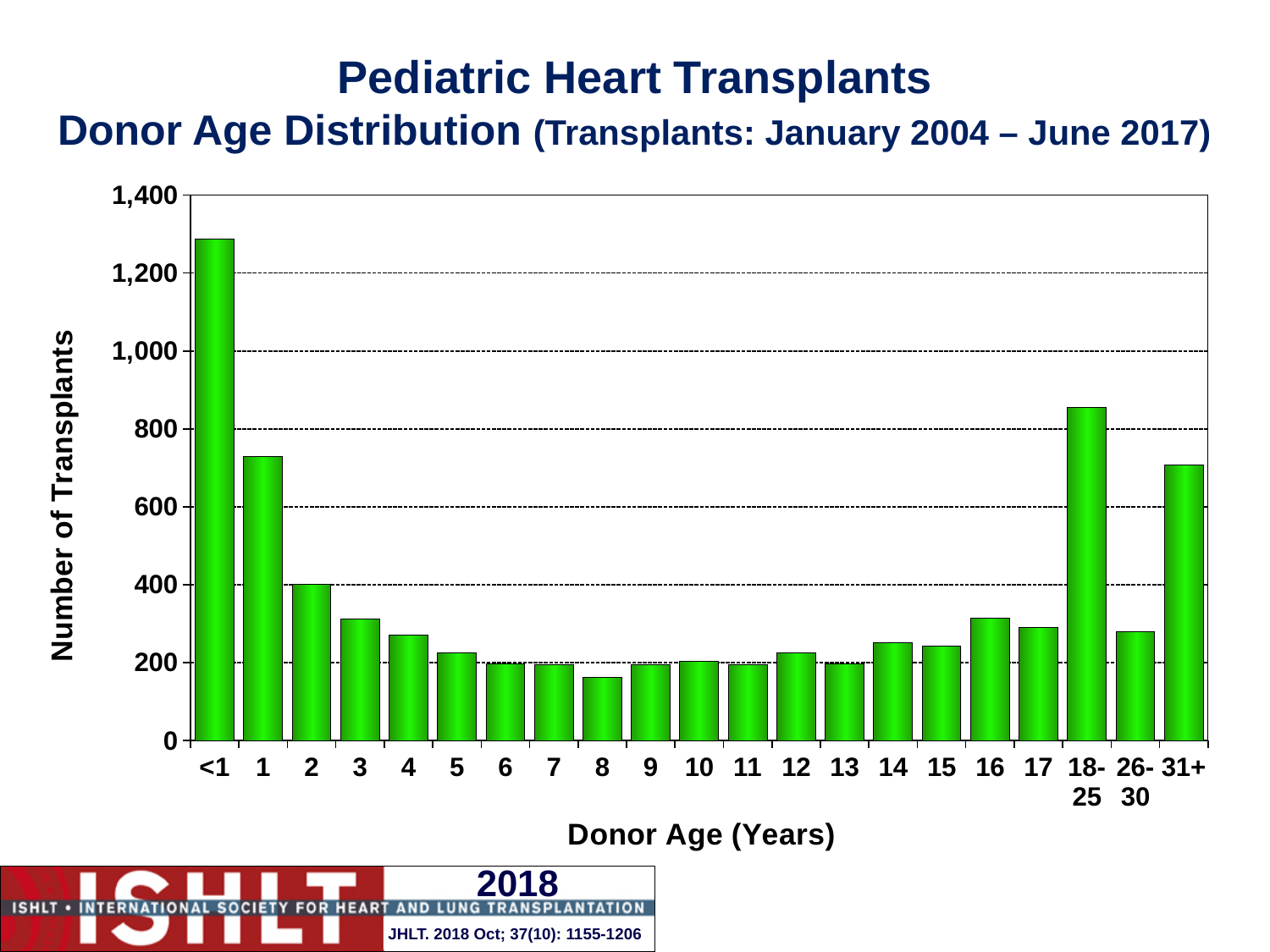
Which donor age category has the lowest number of transplants? 8 What is the label of the y axis? Number of Transplants Which has more transplants, donor age 18-25 or donor age 31+? 18-25 Is the number of transplants for donor age 8 greater or less than 200? less What kind of chart is shown on the slide? bar chart Is the number of transplants for donor age 18-25 greater or less than 800? greater How many donor age categories are shown on the x axis? 21 Which donor age category has the highest number of transplants? <1 Is the number of transplants for donor age 31+ greater or less than 600? greater Do the number of transplants rise or fall from donor age 1 to donor age 8? fall